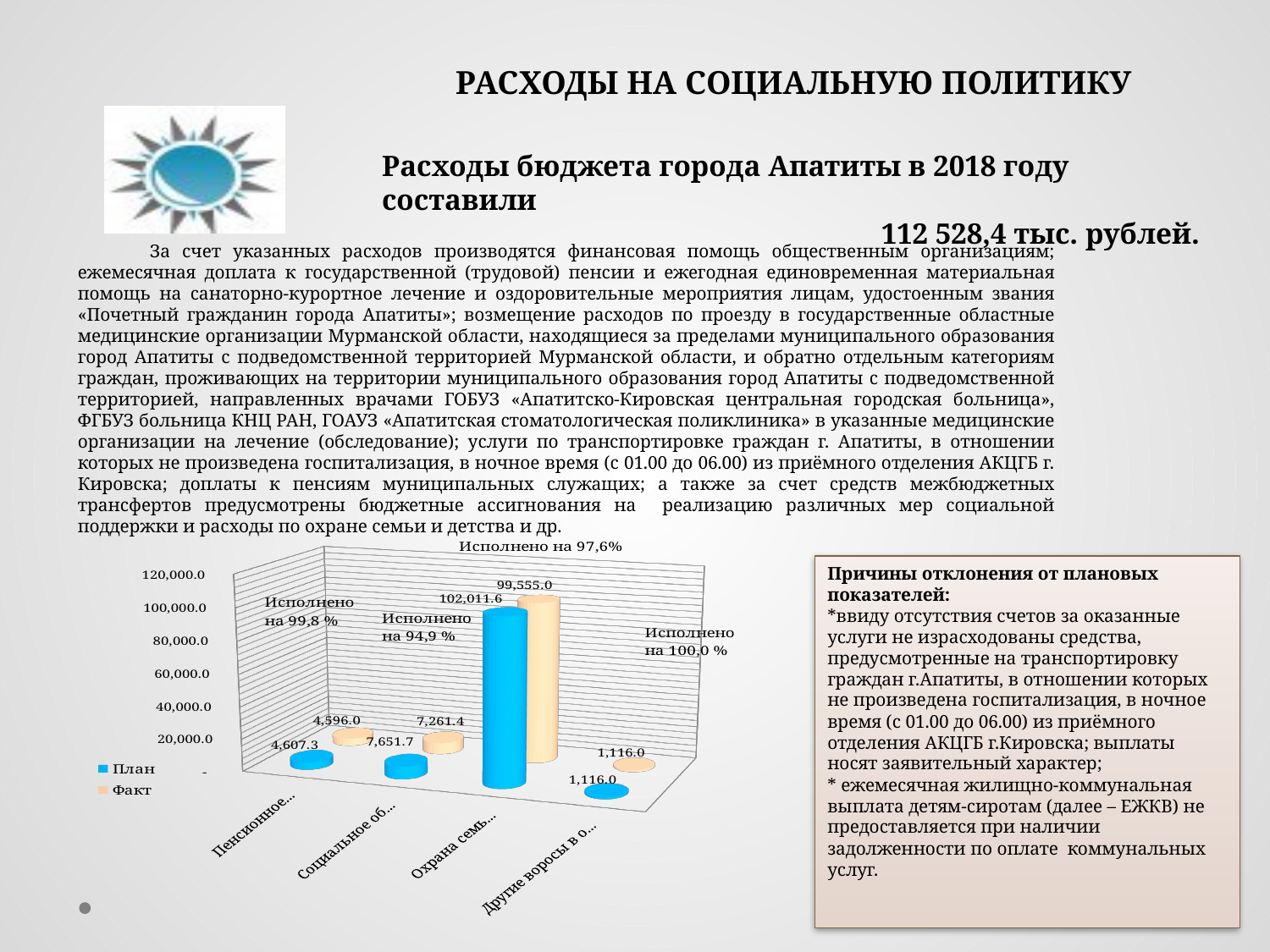
What is the Факт value for the category 'Охрана семь...'? 99,555.0 Which is larger for 'Пенсионное...': the План value or the Факт value? План What is the План value for the category 'Охрана семь...'? 102,011.6 How many series does the chart legend list? 2 What is the difference between the План and Факт values for 'Социальное об...'? 390.3 What type of chart is shown on the slide? bar chart What is the Факт value for the category 'Социальное об...'? 7,261.4 Which category has the lowest Факт value? Другие воросы в о... Which category has the highest План value? Охрана семь... What is the План value for the category 'Пенсионное...'? 4,607.3 How many categories are shown on the chart's x axis? 4 What are the two series named in the chart legend? План and Факт